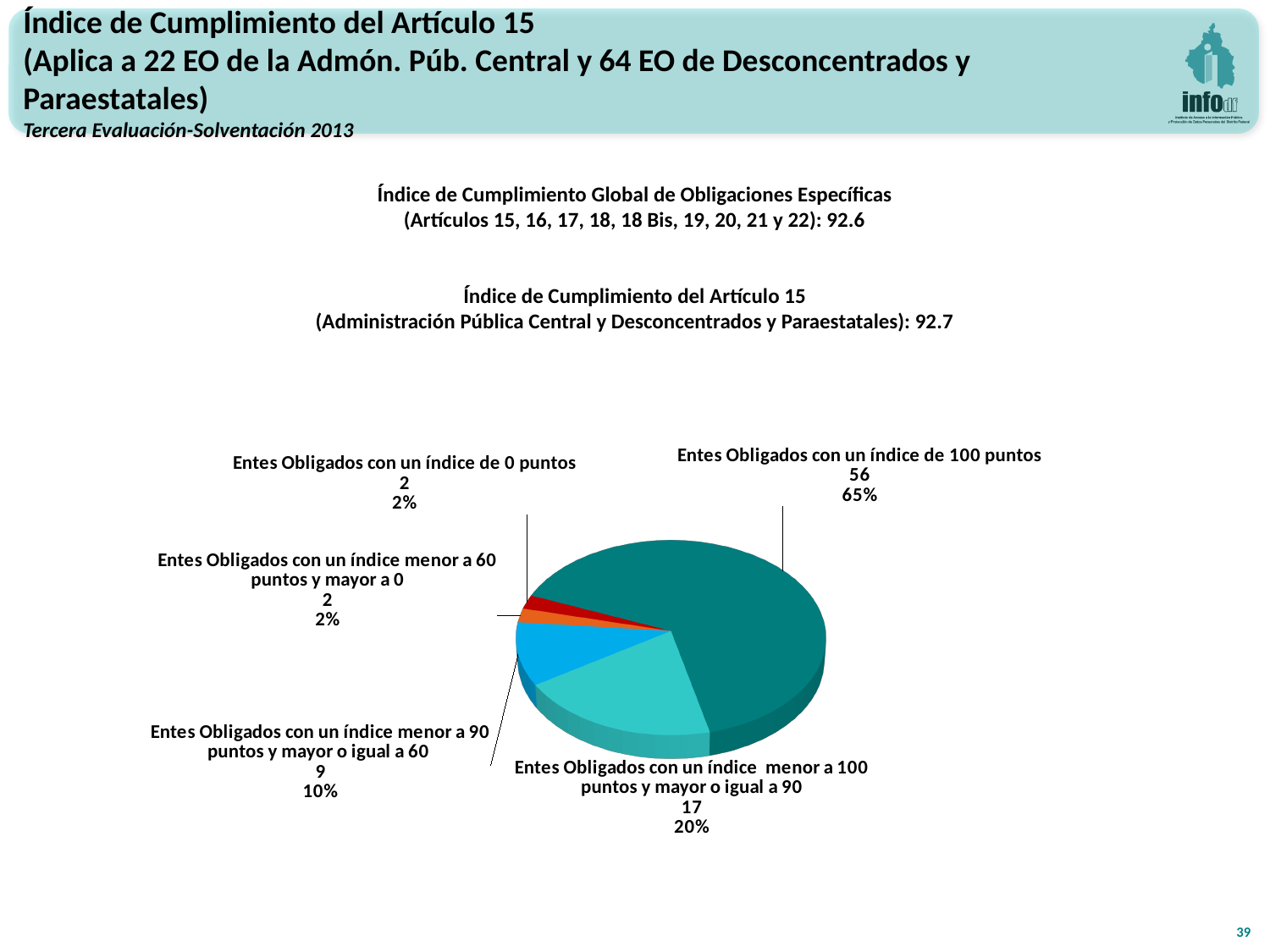
What percentage of the pie corresponds to Entes Obligados con un índice de 100 puntos? 65% Which category has the largest slice of the pie? Entes Obligados con un índice de 100 puntos What share of the pie is Entes Obligados con un índice menor a 90 puntos y mayor o igual a 60? 10% What is the Índice de Cumplimiento del Artículo 15 value stated on the slide? 92.7 How many Entes Obligados have an índice menor a 100 puntos y mayor o igual a 90? 17 How many slices does the pie chart have? 5 What is the difference in count between Entes Obligados con un índice de 100 puntos and those con un índice menor a 100 puntos y mayor o igual a 90? 39 What is the total number of Entes Obligados across all slices of the pie? 86 How many Entes Obligados have an índice de 100 puntos? 56 What kind of chart is shown on the slide? pie chart Which is larger: the number of Entes Obligados con un índice menor a 90 puntos y mayor o igual a 60, or the number con un índice menor a 60 puntos y mayor a 0? Entes Obligados con un índice menor a 90 puntos y mayor o igual a 60 How many Entes Obligados have an índice de 0 puntos? 2